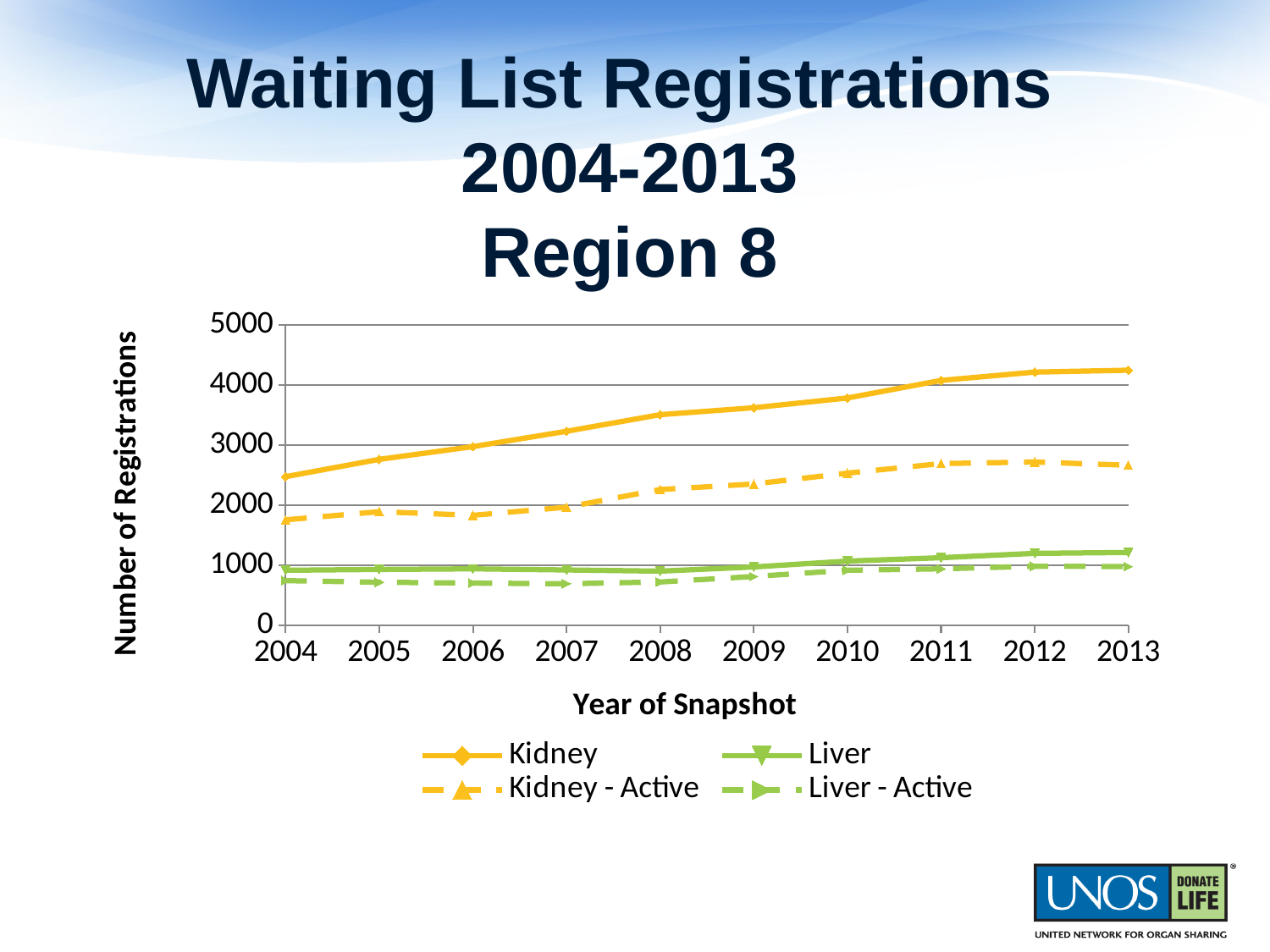
How many series does the legend list? 4 What kind of chart is shown on the slide? line chart Is the value for Kidney in 2008 greater or less than 3000? greater How many years are plotted along the x axis? 10 Is the value for Liver - Active in 2004 greater or less than 1000? less Which series has the highest values across the chart? Kidney In 2013, which is larger: Kidney or Liver? Kidney Is the value for Kidney - Active in 2004 greater or less than 2000? less What is the title of the y axis? Number of Registrations Do the Kidney registrations rise or fall from 2004 to 2013? rise Which series has the lowest values across the chart? Liver - Active